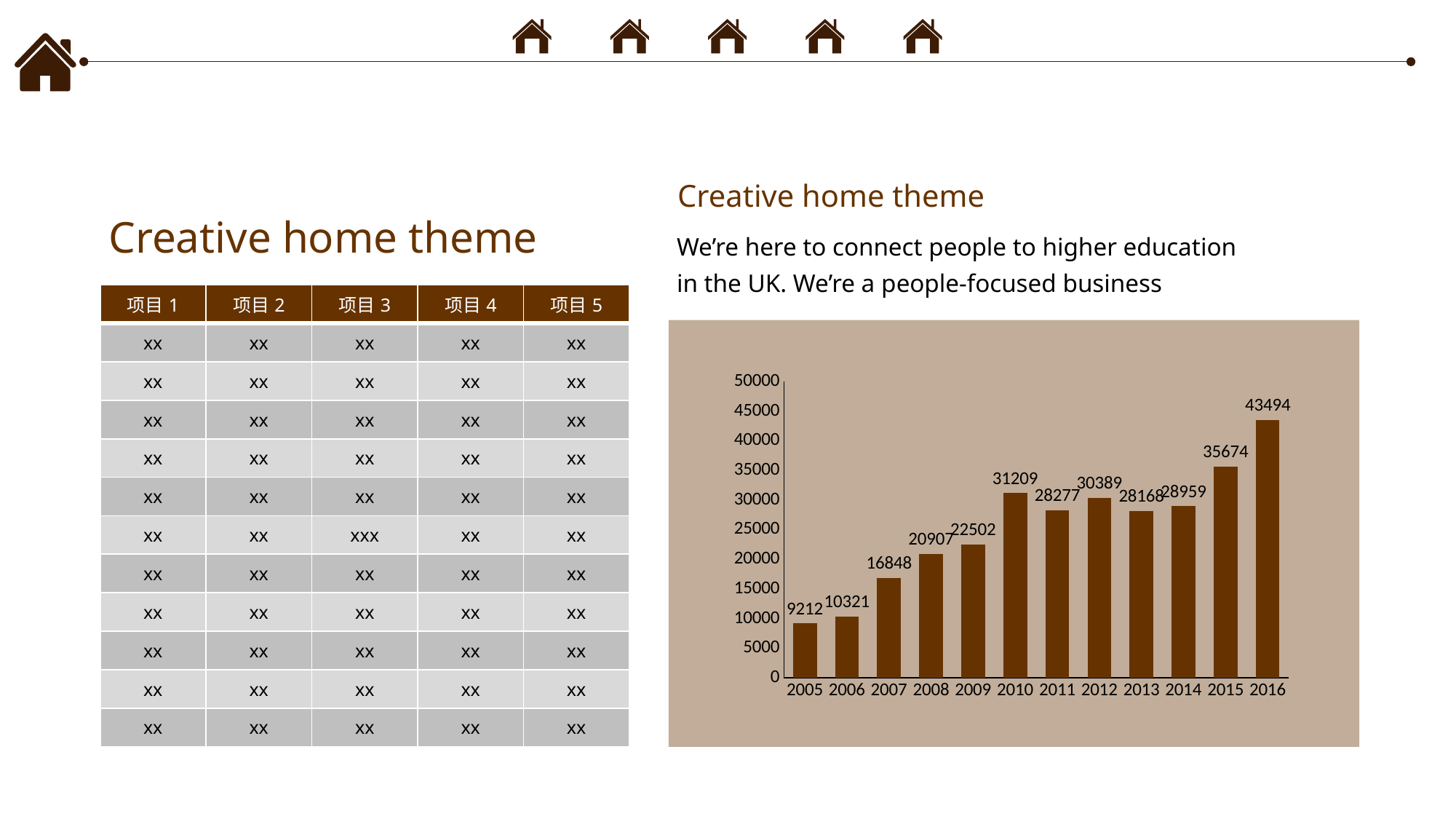
What kind of chart is shown on the slide? bar chart Do the values generally rise or fall from 2005 to 2016? rise What is the difference between the values for 2007 and 2006? 6527 Which year has the highest value? 2016 Which is larger, the value for 2010 or the value for 2012? 2010 Is the value for 2009 greater or less than 25000? less What is the value for 2005? 9212 Which year has the lowest value? 2005 What is the difference between the values for 2016 and 2015? 7820 What is the value for 2010? 31209 How many years are shown on the x axis? 12 What is the value for 2015? 35674